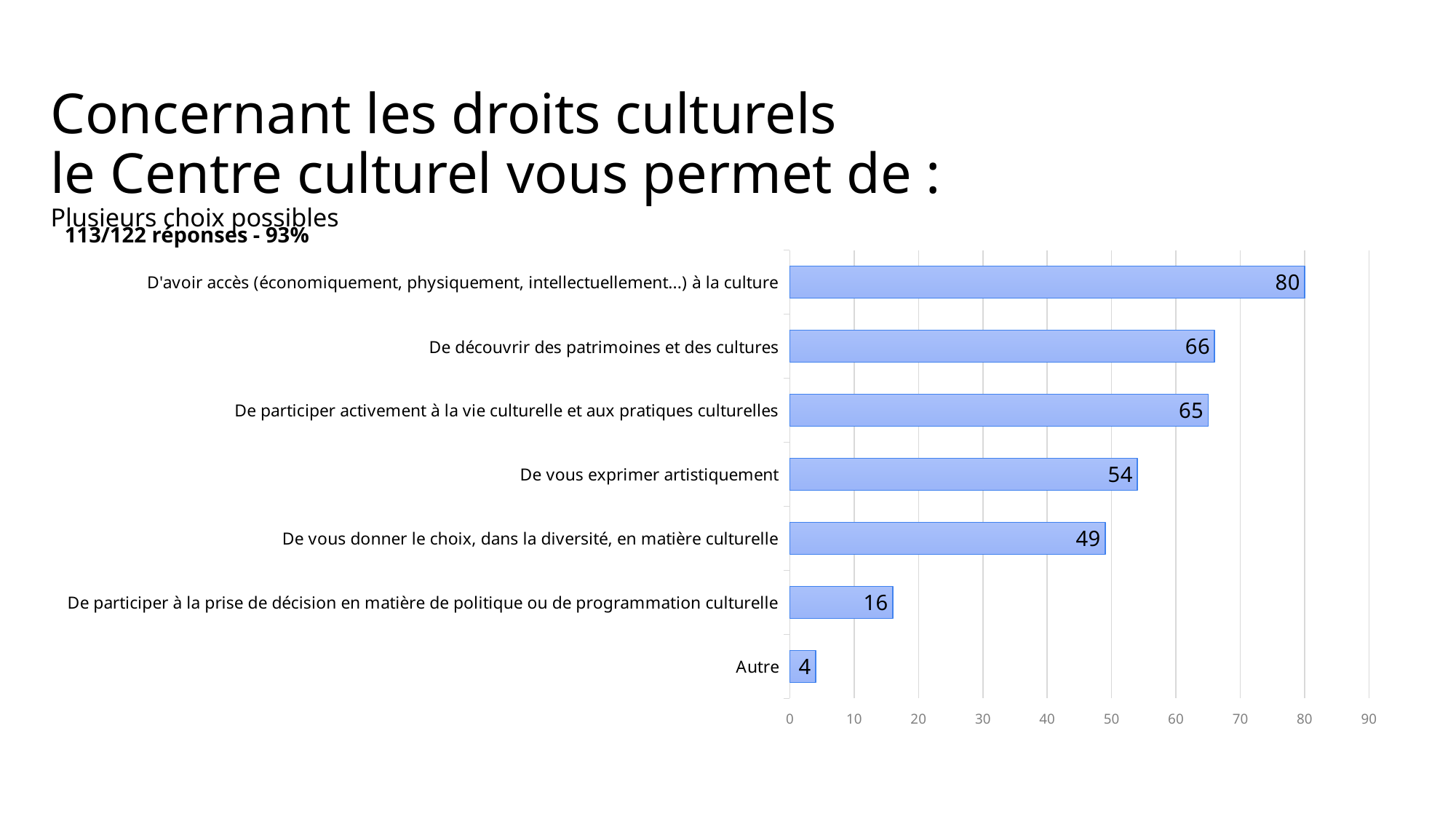
What is the difference between the values for "D'avoir accès (économiquement, physiquement, intellectuellement...) à la culture" and "De découvrir des patrimoines et des cultures"? 14 Which category has the lowest value? Autre How many categories are shown in the chart? 7 What is the difference between the values for "De vous donner le choix, dans la diversité, en matière culturelle" and "De participer à la prise de décision en matière de politique ou de programmation culturelle"? 33 What is the response count shown above the chart? 113/122 réponses - 93% Which category has the highest value? D'avoir accès (économiquement, physiquement, intellectuellement...) à la culture What is the value for "Autre"? 4 What kind of chart is shown on the slide? bar chart Which is larger: the value for "De vous exprimer artistiquement" or the value for "De vous donner le choix, dans la diversité, en matière culturelle"? De vous exprimer artistiquement Is the value for "De participer activement à la vie culturelle et aux pratiques culturelles" greater or less than 60? greater What is the value for "De vous exprimer artistiquement"? 54 What is the value for "De participer à la prise de décision en matière de politique ou de programmation culturelle"? 16